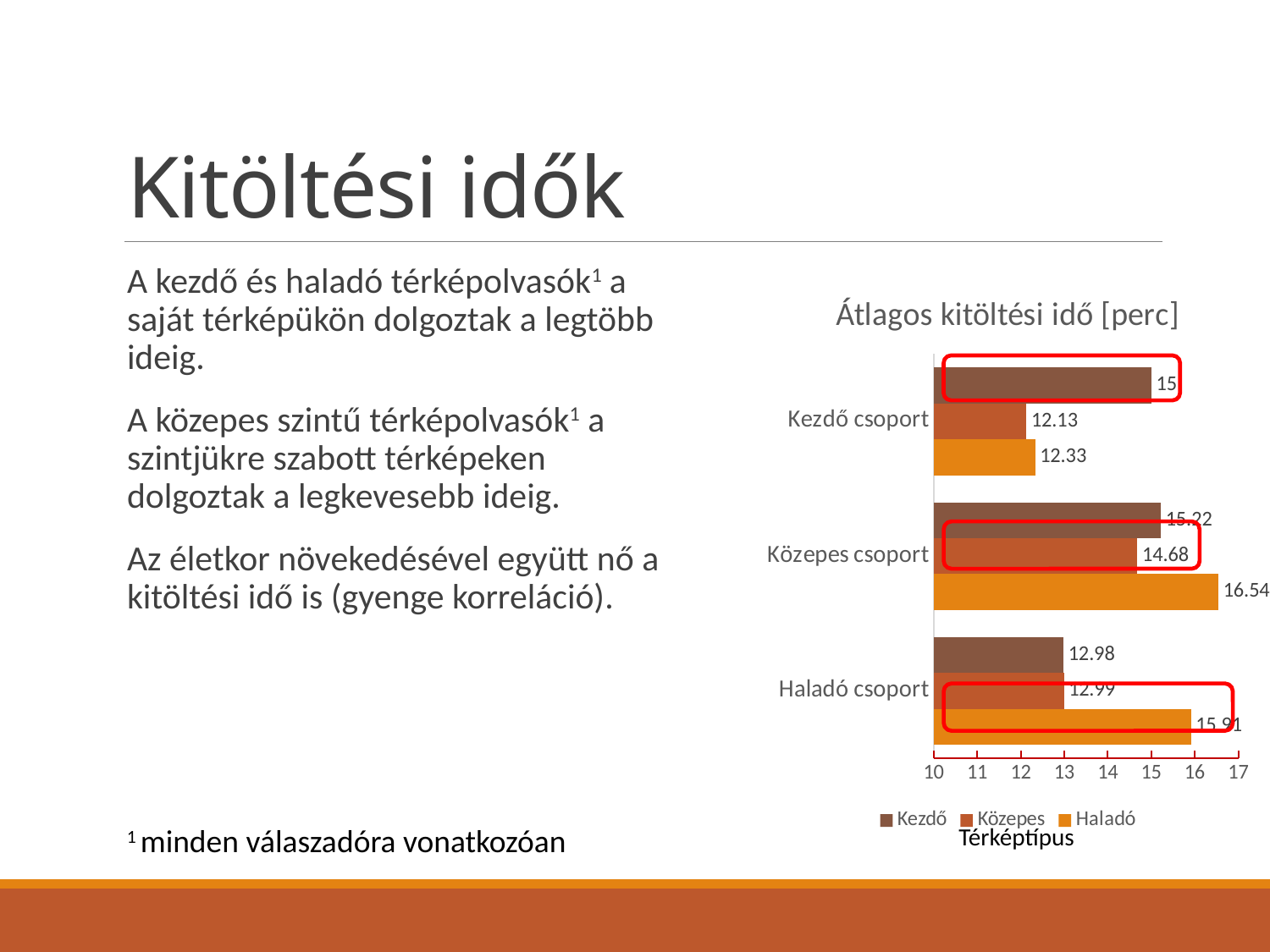
What is the value of the Kezdő series for Haladó csoport? 12.98 What is the value of the Közepes series for Kezdő csoport? 12.13 How many series does the chart legend list? 3 What is the title of the chart? Átlagos kitöltési idő [perc] Is the value of the Haladó series for Haladó csoport greater or less than 15? greater Which series has the highest value for Közepes csoport? Haladó What is the value of the Közepes series for Közepes csoport? 14.68 How many groups (categories) are shown on the chart? 3 What kind of chart is shown on the slide? bar chart What is the difference between the Kezdő and Közepes series values for Kezdő csoport? 2.87 What is the value of the Kezdő series for Kezdő csoport? 15 What is the value of the Haladó series for Közepes csoport? 16.54